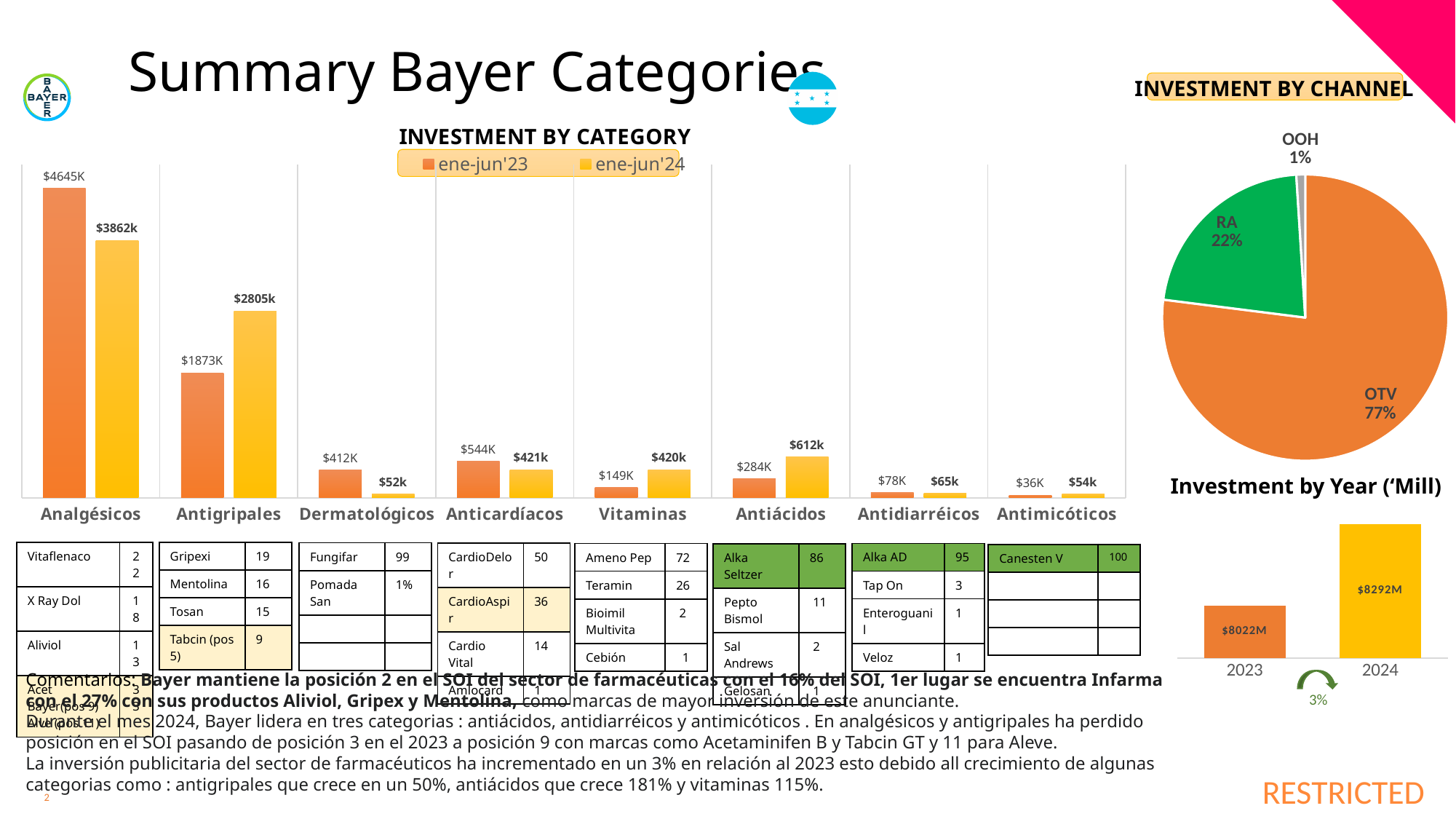
In the INVESTMENT BY CATEGORY chart, what is the difference between the ene-jun'23 and ene-jun'24 values for Analgésicos? $783K In the INVESTMENT BY CATEGORY chart, how many categories are shown on the x axis? 8 In the INVESTMENT BY CATEGORY chart, which category has the lowest ene-jun'23 value? Antimicóticos In the INVESTMENT BY CATEGORY chart, what is the ene-jun'24 value for Antigripales? $2805k In the INVESTMENT BY CHANNEL chart, what share does OTV have? 77% In the INVESTMENT BY CATEGORY chart, what is the ene-jun'23 value for Vitaminas? $149K In the Investment by Year ('Mill) chart, do the values rise or fall from 2023 to 2024? Rise What kind of chart is the INVESTMENT BY CHANNEL chart? Pie chart In the INVESTMENT BY CATEGORY chart, how many series does the legend list? 2 In the INVESTMENT BY CATEGORY chart, which category has the highest ene-jun'23 value? Analgésicos In the Investment by Year ('Mill) chart, what is the value for 2024? $8292M In the INVESTMENT BY CATEGORY chart, which is larger for Antiácidos: the ene-jun'23 value or the ene-jun'24 value? ene-jun'24